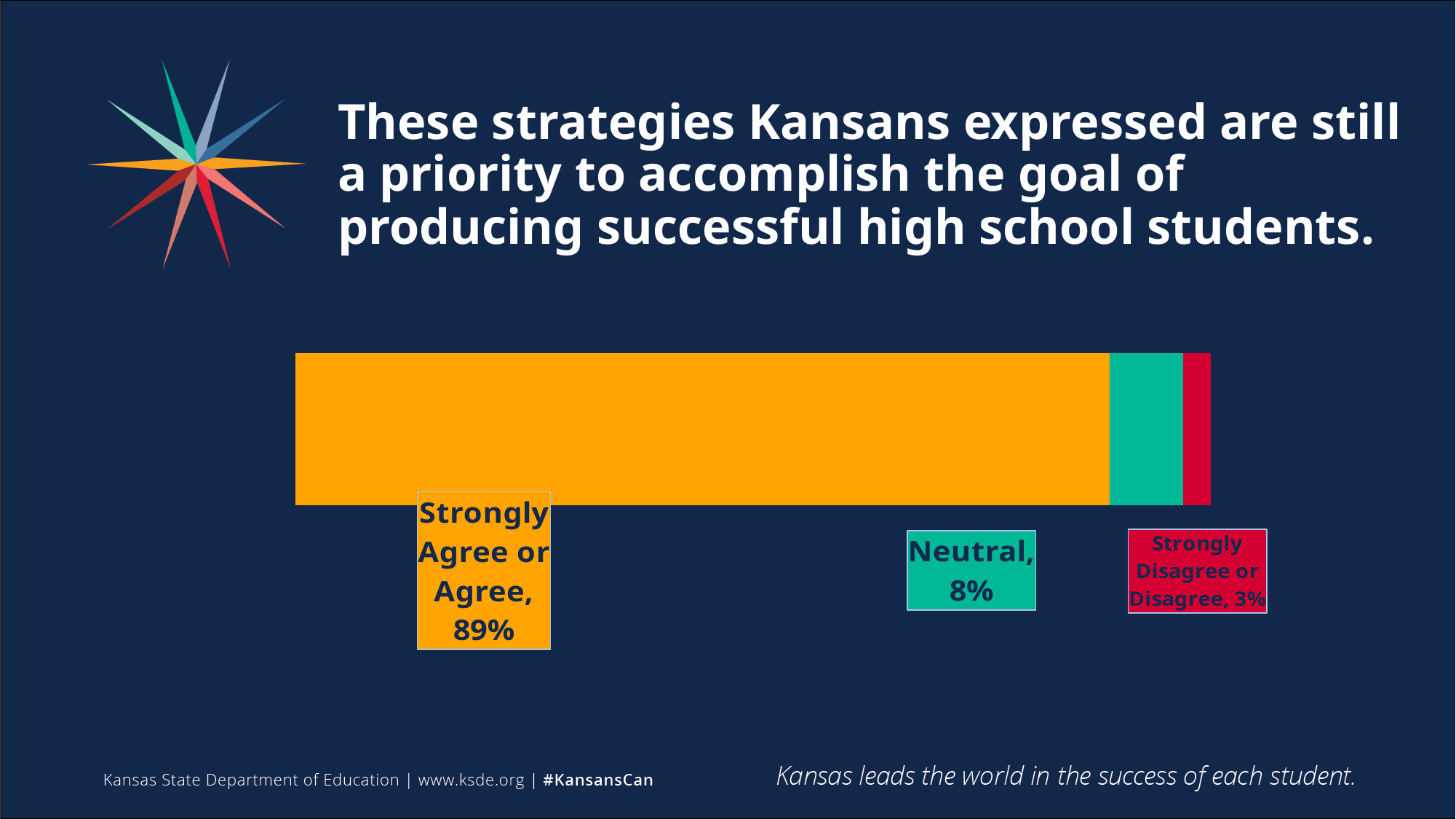
How many response categories are shown in the bar? 3 Which response category has the highest percentage? Strongly Agree or Agree What percentage of respondents answered Strongly Agree or Agree? 89% What percentage of respondents answered Strongly Disagree or Disagree? 3% What colour is the Neutral segment of the bar? Teal/green Which is larger, the Neutral share or the Strongly Disagree or Disagree share? Neutral What kind of chart is shown on the slide? Stacked bar chart What is the total of the three segments in the stacked bar? 100% What is the difference in percentage points between Strongly Agree or Agree and Neutral? 81 What is the difference in percentage points between Neutral and Strongly Disagree or Disagree? 5 What percentage of respondents answered Neutral? 8% Which response category has the lowest percentage? Strongly Disagree or Disagree